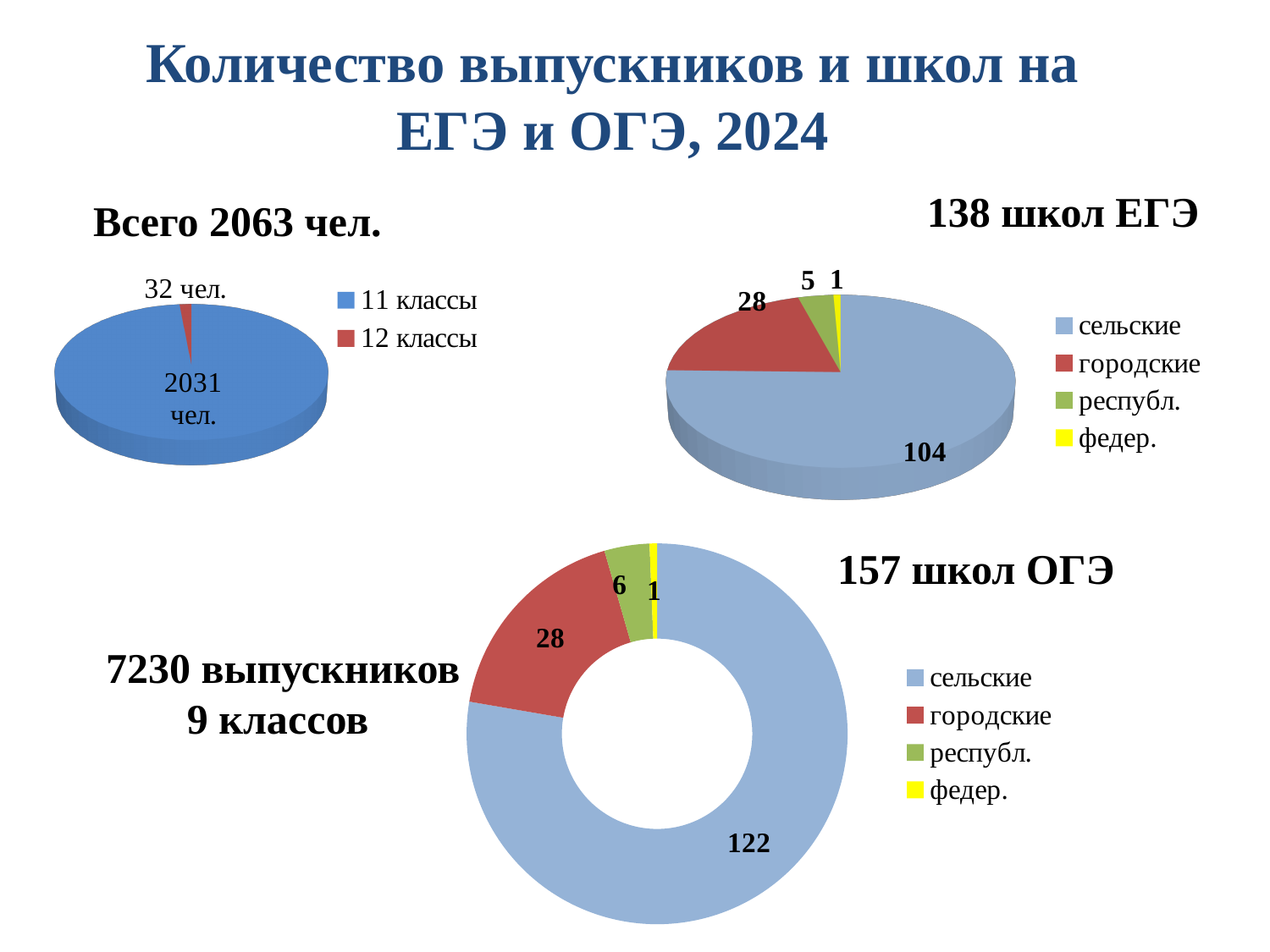
In the chart titled "157 школ ОГЭ", what is the value for республ.? 6 In the chart titled "Всего 2063 чел.", what is the value for 11 классы? 2031 чел. In the chart titled "138 школ ЕГЭ", what colour represents федер.? yellow What kind of chart is the one titled "157 школ ОГЭ"? doughnut chart In the chart titled "157 школ ОГЭ", how many categories does the legend list? 4 In the chart titled "138 школ ЕГЭ", what is the difference between сельские and городские? 76 In the chart titled "138 школ ЕГЭ", which category has the lowest value? федер. In the chart titled "138 школ ЕГЭ", which category has the highest value? сельские In the chart titled "157 школ ОГЭ", which is larger, городские or республ.? городские In the chart titled "Всего 2063 чел.", what is the value for 12 классы? 32 чел. In the chart titled "157 школ ОГЭ", what is the value for сельские? 122 In the chart titled "138 школ ЕГЭ", what is the value for городские? 28